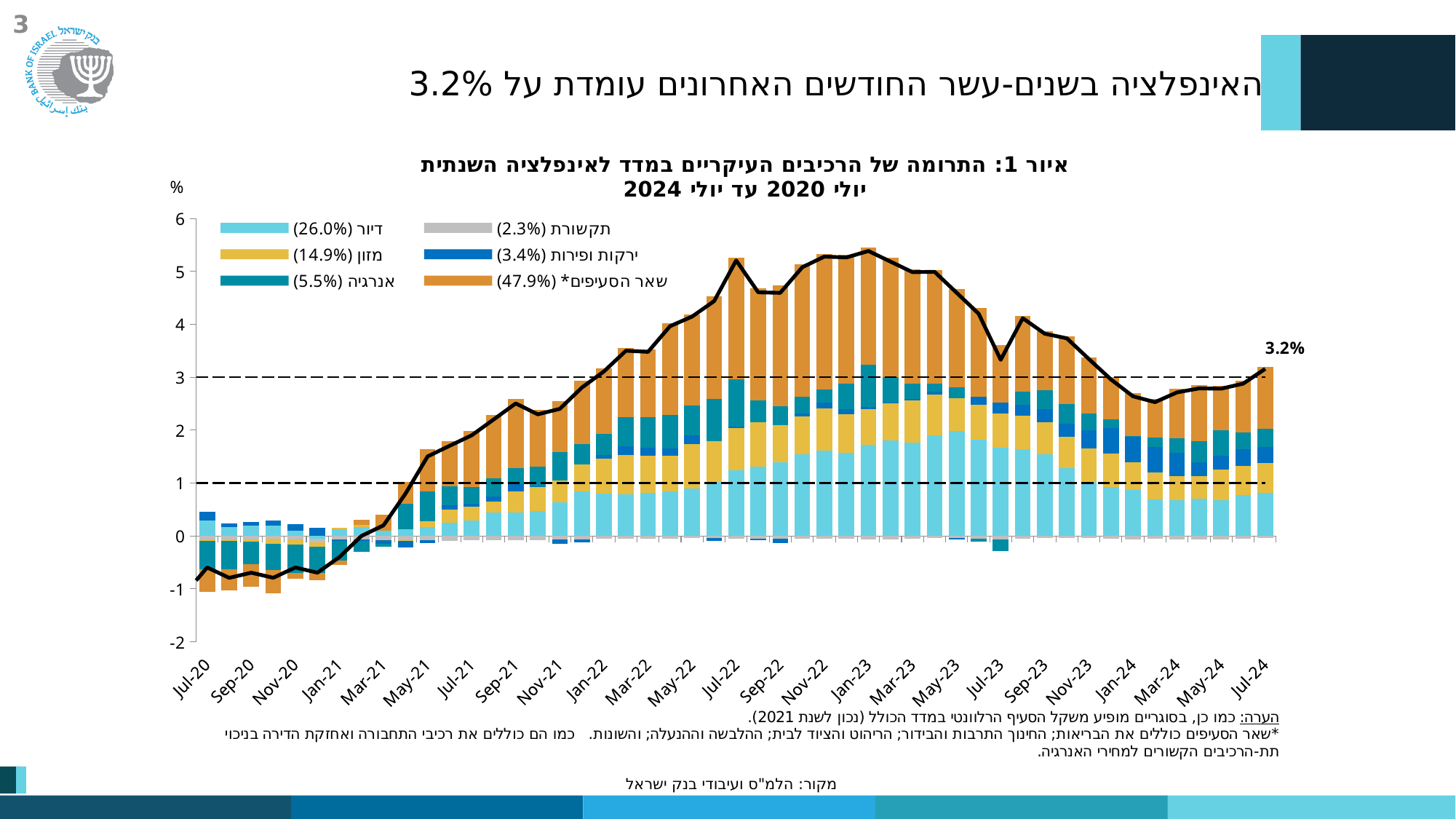
What kind of chart is shown on the slide? Stacked bar chart with a line How many month labels are shown on the x axis? 25 What value is printed as a data label at the end of the line for Jul-24? 3.2% What weight is shown in the legend for שאר הסעיפים*? 47.9% Which has the higher line value, Jul-22 or Jul-23? Jul-22 Is the value of the line for Jan-23 greater or less than 5? greater Is the value of the line for Jul-23 greater or less than 4? less Is the value of the line for Jul-20 greater or less than 0? less Does the line rise or fall between Jan-23 and Jan-24? fall How many series does the legend list? 6 Does the line rise or fall between Mar-21 and Jan-23? rise